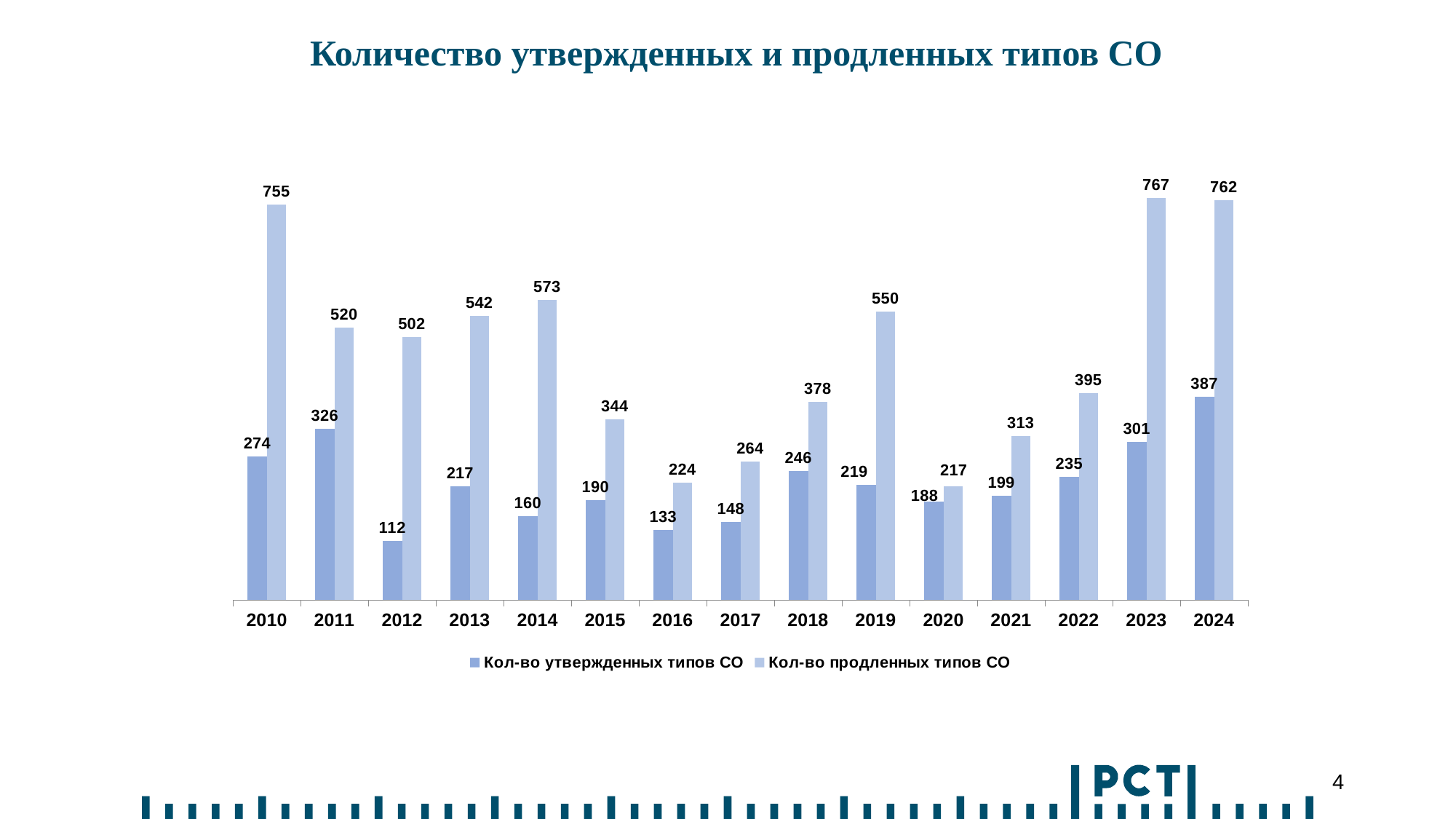
How many years are shown on the x axis? 15 How many series does the legend list? 2 What is the value of 'Кол-во утвержденных типов СО' for 2016? 133 What is the title of the chart? Количество утвержденных и продленных типов СО What is the value of 'Кол-во утвержденных типов СО' for 2012? 112 Does 'Кол-во утвержденных типов СО' rise or fall from 2020 to 2024? Rise What kind of chart is shown on the slide? Bar chart What is the value of 'Кол-во продленных типов СО' for 2019? 550 Which year has the lowest value for 'Кол-во утвержденных типов СО'? 2012 What is the difference between 'Кол-во продленных типов СО' and 'Кол-во утвержденных типов СО' in 2024? 375 Which is larger: 'Кол-во утвержденных типов СО' in 2011 or in 2024? 2024 Which year has the highest value for 'Кол-во продленных типов СО'? 2023